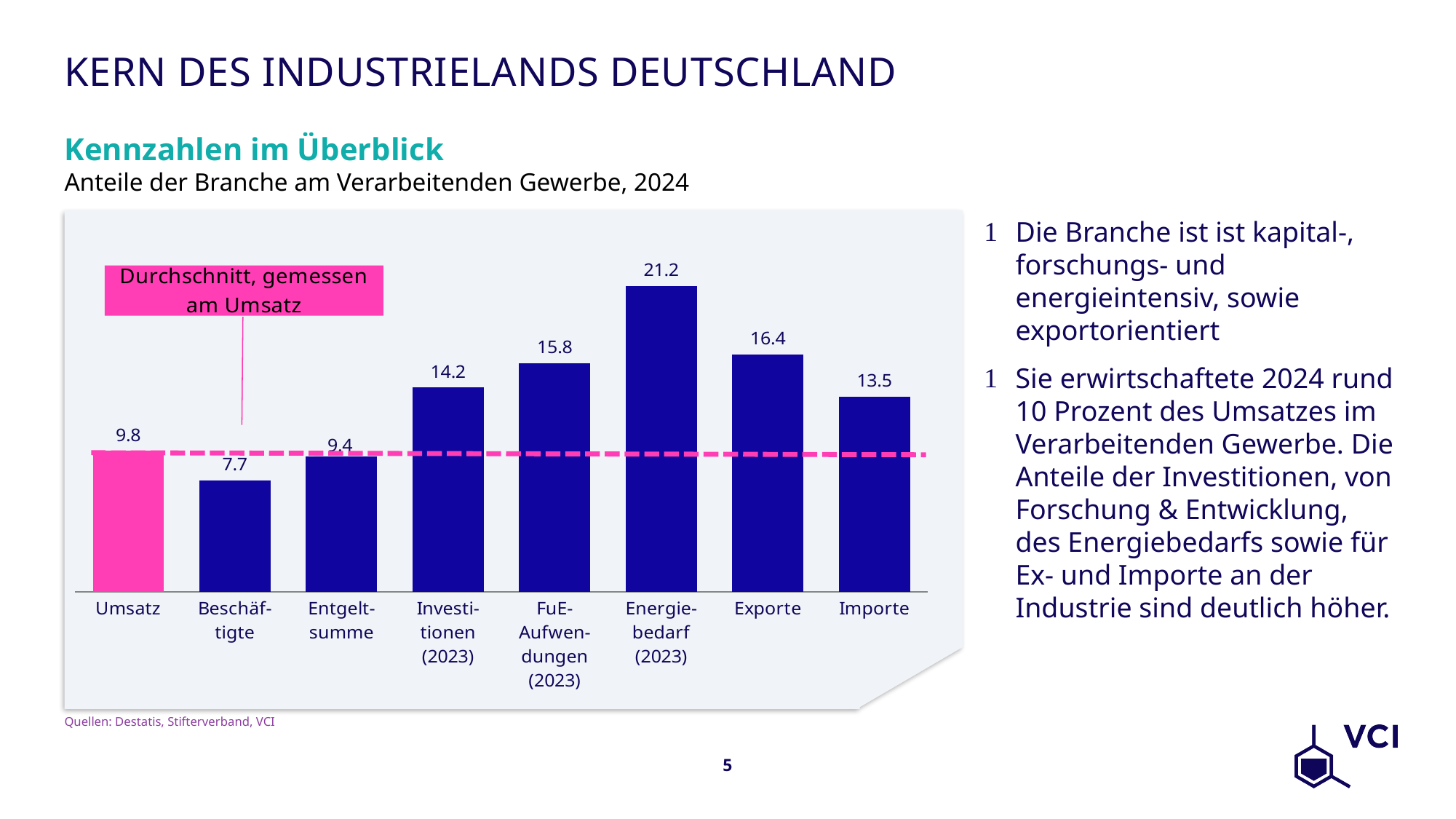
Which category has the highest value? Energiebedarf (2023) What is the value for Importe? 13.5 What is the value for Beschäftigte? 7.7 What is the value for Energiebedarf (2023)? 21.2 What is the value for Umsatz? 9.8 Which category has the lowest value? Beschäftigte What kind of chart is shown on the slide? Bar chart How many categories are shown in the chart? 8 What does the pink dashed line in the chart represent? Durchschnitt, gemessen am Umsatz What is the difference between the values for FuE-Aufwendungen (2023) and Investitionen (2023)? 1.6 Which is larger, the value for Entgeltsumme or the value for Beschäftigte? Entgeltsumme What is the difference between the values for Exporte and Importe? 2.9